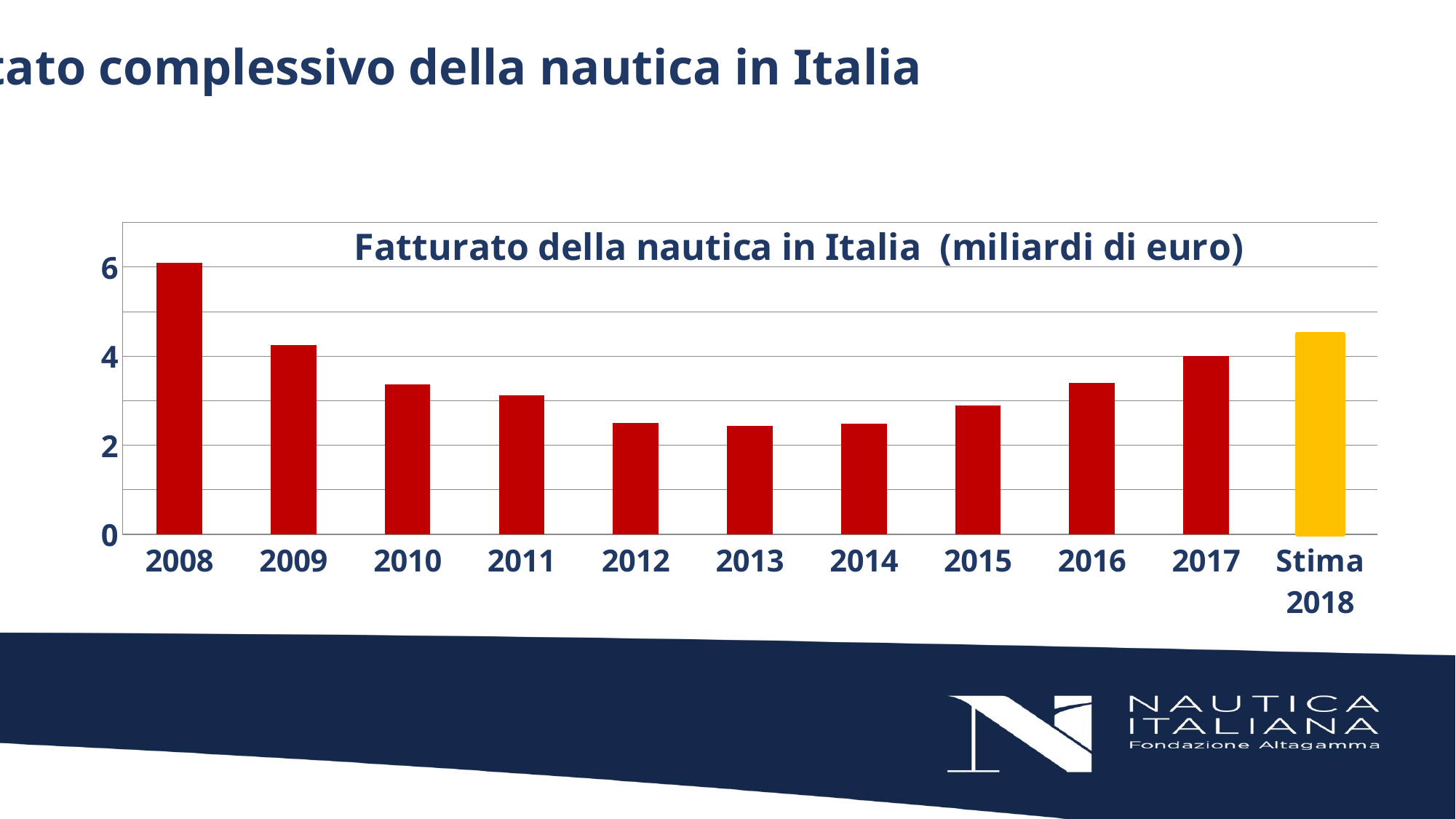
Which is larger, the value for 2008 or the value for 2009? 2008 How many categories are shown on the x axis of the chart? 11 Do the values rise or fall from 2008 to 2013? fall Is the value for Stima 2018 greater or less than 4? greater Which bar is shown in a different colour (yellow) from the others? Stima 2018 Is the value for 2009 greater or less than 4? greater What kind of chart is shown on the slide? Bar chart What is the title of the chart? Fatturato della nautica in Italia (miliardi di euro) Which year has the highest value in the chart? 2008 Is the value for 2012 greater or less than 2? greater Which is larger, the value for 2017 or the value for Stima 2018? Stima 2018